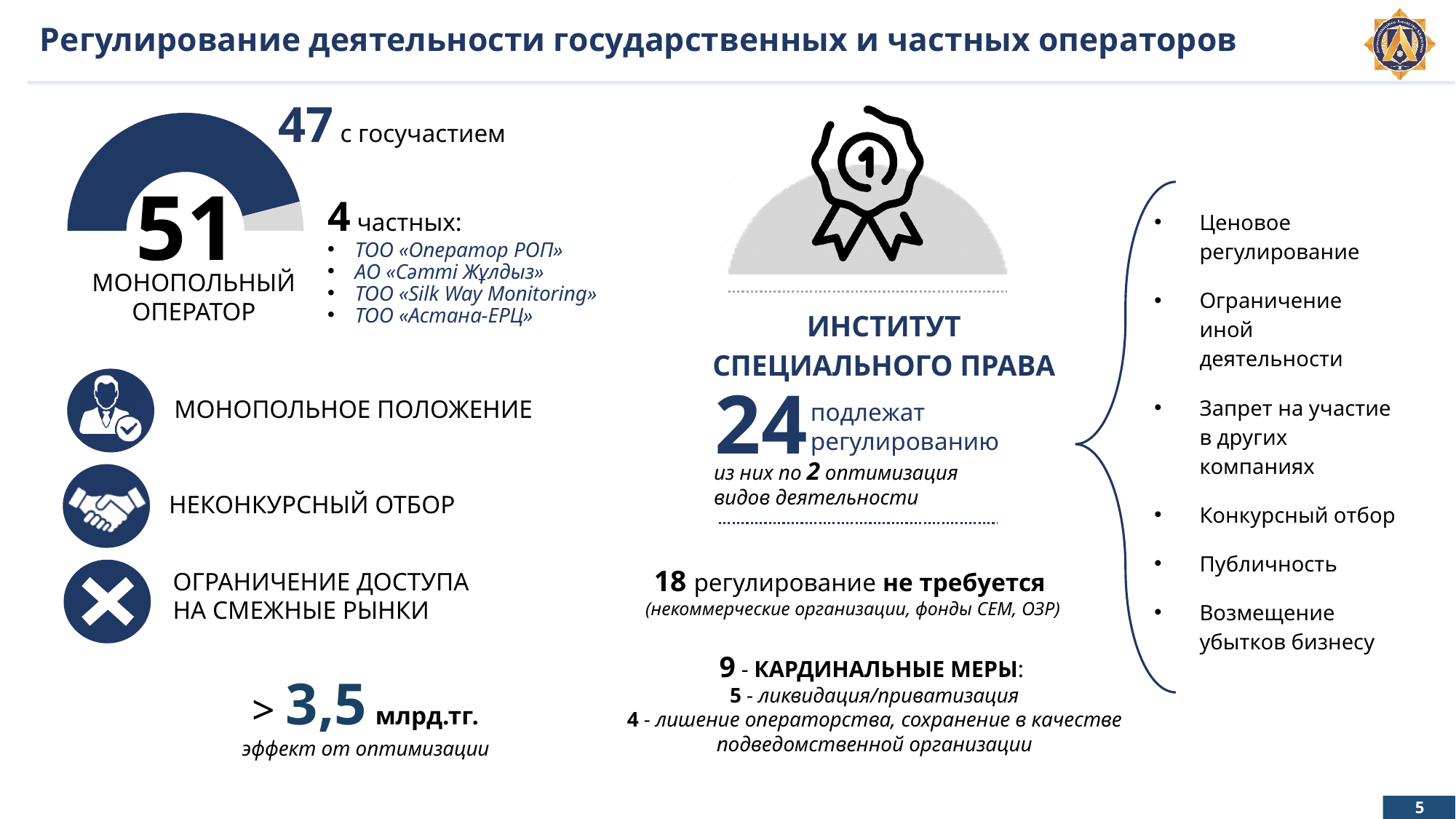
In the semicircular chart on the left, which segment is the smallest? Private operators (4) In the semicircular chart on the left, how many operators are private (частных)? 4 In the semicircular chart on the left, how many monopoly operators are shown in total? 51 In the semicircular chart on the left, which group is larger: operators with state participation or private operators? Operators with state participation (47) What label is written in the centre of the semicircular chart on the left? 51 МОНОПОЛЬНЫЙ ОПЕРАТОР In the semicircular chart on the left, which segment is the largest? Operators with state participation (47) In the semicircular chart on the left, what colour is the segment representing operators with state participation? Dark blue In the semicircular chart on the left, what is the difference between the number of operators with state participation and the number of private operators? 43 What kind of chart is used on the left of the slide to show the 51 monopoly operators? A semicircular doughnut (gauge) chart How many private operators are listed by name next to the semicircular chart on the left? 4 In the semicircular chart on the left, how many operators are with state participation (с госучастием)? 47